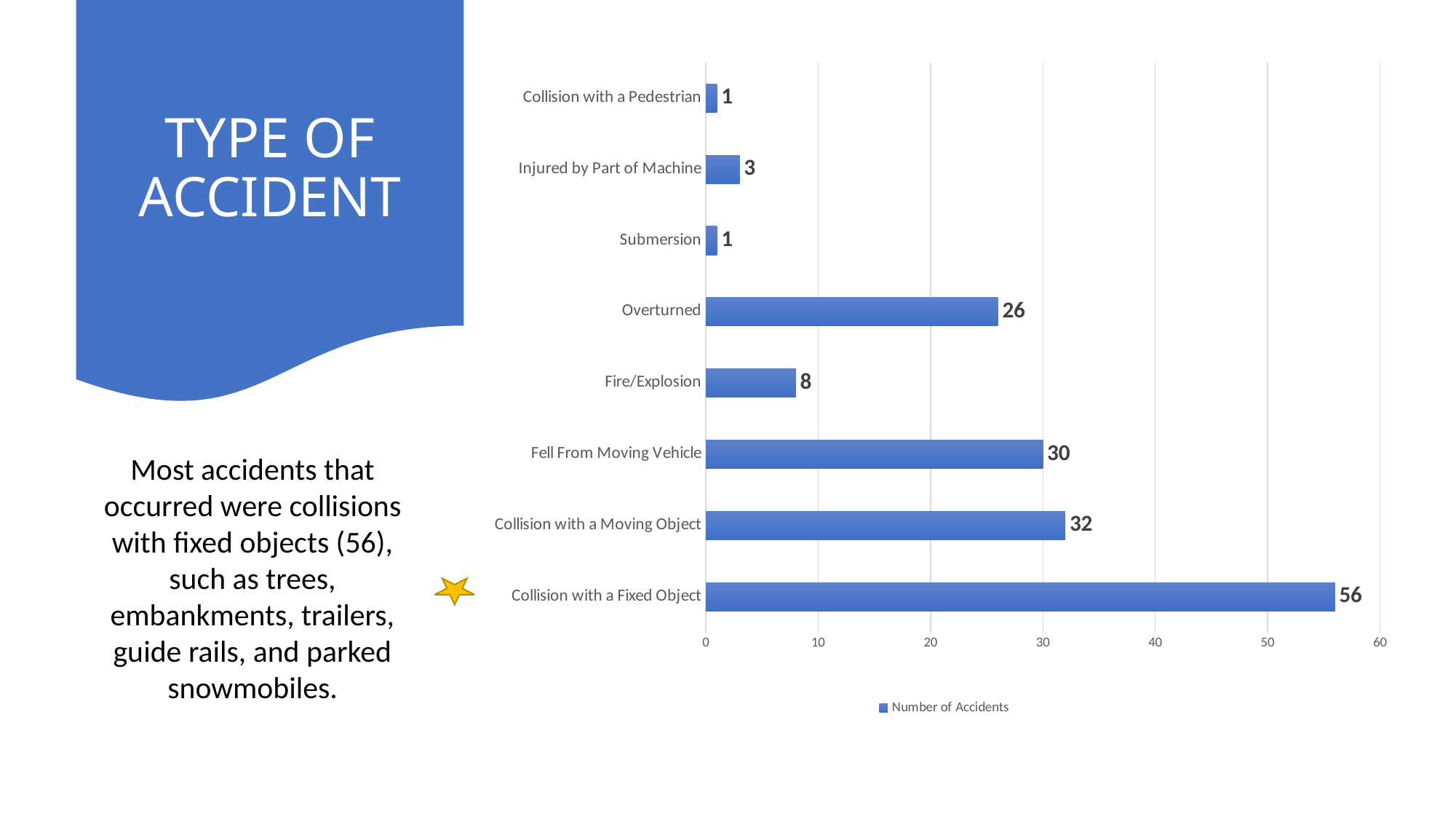
What is the legend entry for the series in the chart? Number of Accidents What is the number of accidents for Collision with a Fixed Object? 56 How many accident types are shown in the chart? 8 Which accident type has the lowest number of accidents, Injured by Part of Machine or Fire/Explosion? Injured by Part of Machine What kind of chart is shown on the slide? bar chart How many series does the legend list? 1 Which accident type has the highest number of accidents? Collision with a Fixed Object What is the difference in number of accidents between Collision with a Fixed Object and Collision with a Moving Object? 24 What is the number of accidents for Overturned? 26 Is the value for Collision with a Moving Object greater or less than 30? greater Which has more accidents, Fell From Moving Vehicle or Overturned? Fell From Moving Vehicle What is the number of accidents for Fire/Explosion? 8